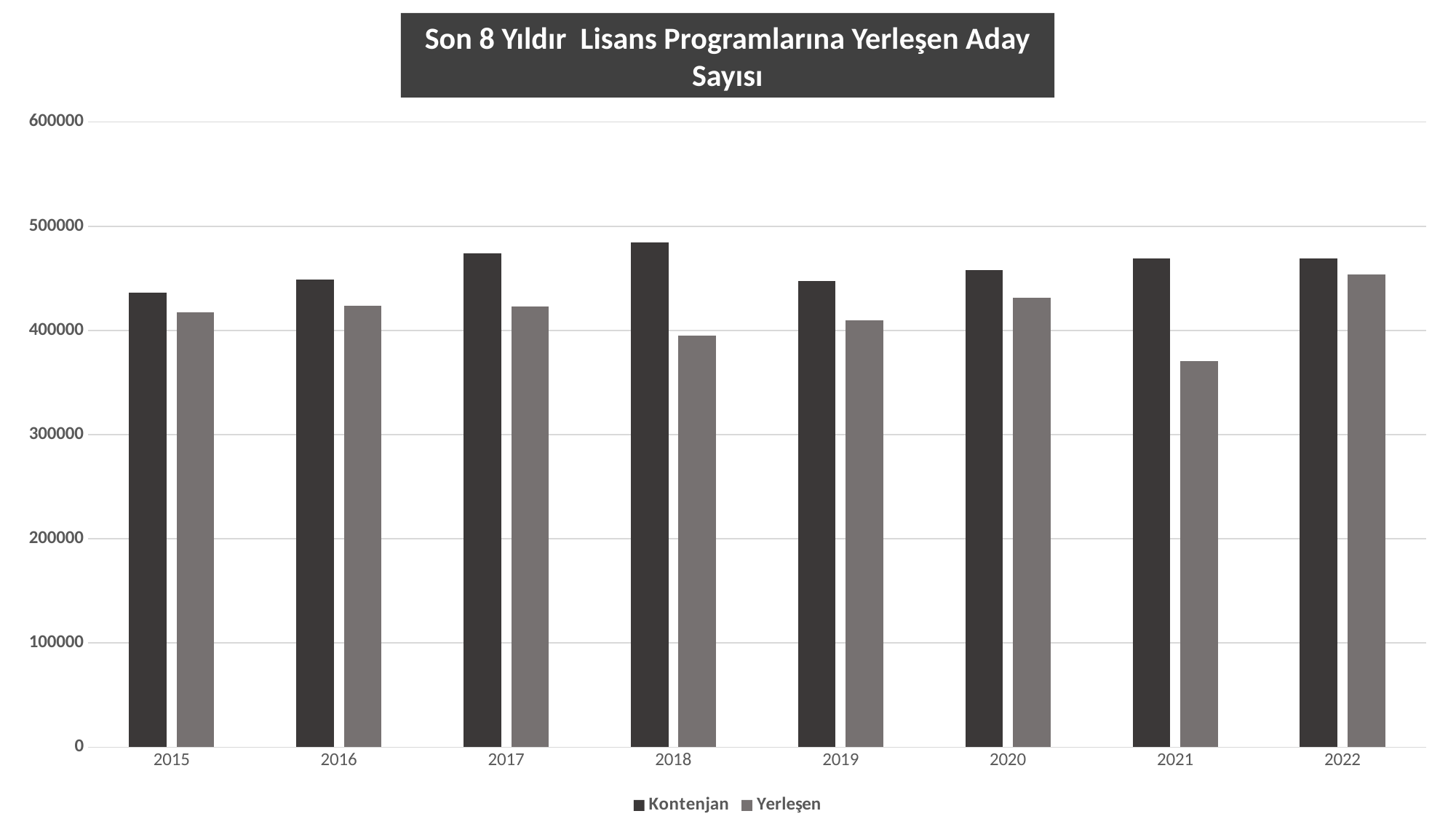
In 2021, which is larger, Kontenjan or Yerleşen? Kontenjan What kind of chart is shown on the slide? bar chart How many years are shown on the x axis? 8 Which year has the larger Yerleşen value, 2021 or 2022? 2022 How many series does the legend list? 2 Is the Kontenjan value for 2018 greater or less than 500000? less Is the Yerleşen value for 2021 greater or less than 400000? less In which year is the Yerleşen value lowest? 2021 In which year is the Kontenjan value highest? 2018 In which year is the Yerleşen value highest? 2022 Is the Yerleşen value for 2022 greater or less than 400000? greater What is the title of the chart? Son 8 Yıldır Lisans Programlarına Yerleşen Aday Sayısı